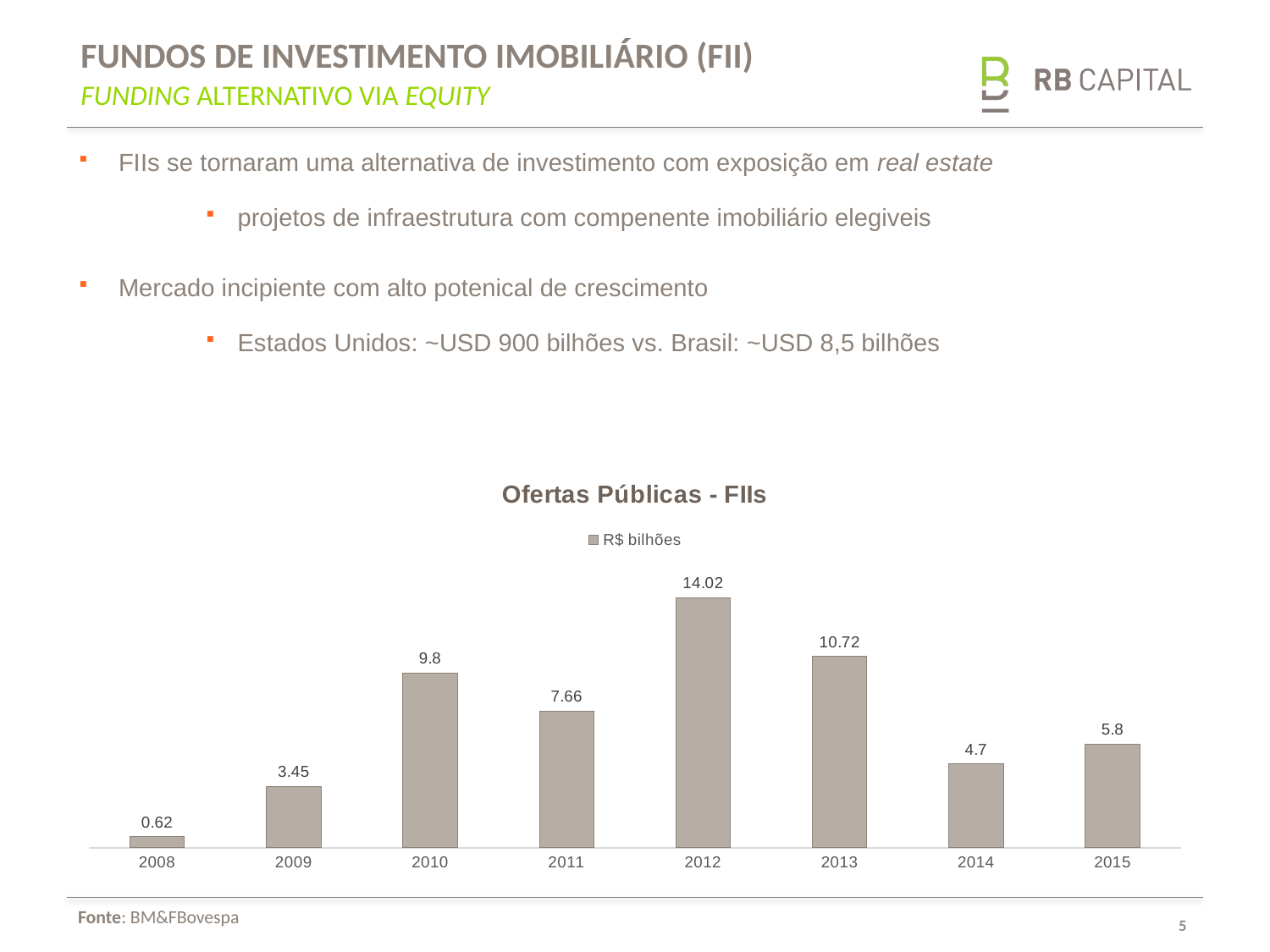
Which is larger in the Ofertas Públicas - FIIs chart, the value for 2014 or the value for 2015? 2015 What is the legend entry in the Ofertas Públicas - FIIs chart? R$ bilhões Which year has the highest value in the Ofertas Públicas - FIIs chart? 2012 What is the value for 2015 in the Ofertas Públicas - FIIs chart? 5.8 What is the difference between the values for 2010 and 2011 in the Ofertas Públicas - FIIs chart? 2.14 What is the value for 2008 in the Ofertas Públicas - FIIs chart? 0.62 What is the value for 2012 in the Ofertas Públicas - FIIs chart? 14.02 Which year has the lowest value in the Ofertas Públicas - FIIs chart? 2008 How many series does the legend of the Ofertas Públicas - FIIs chart list? 1 What kind of chart is the Ofertas Públicas - FIIs chart? Bar chart What is the difference between the values for 2012 and 2013 in the Ofertas Públicas - FIIs chart? 3.3 How many years are shown on the x axis of the Ofertas Públicas - FIIs chart? 8